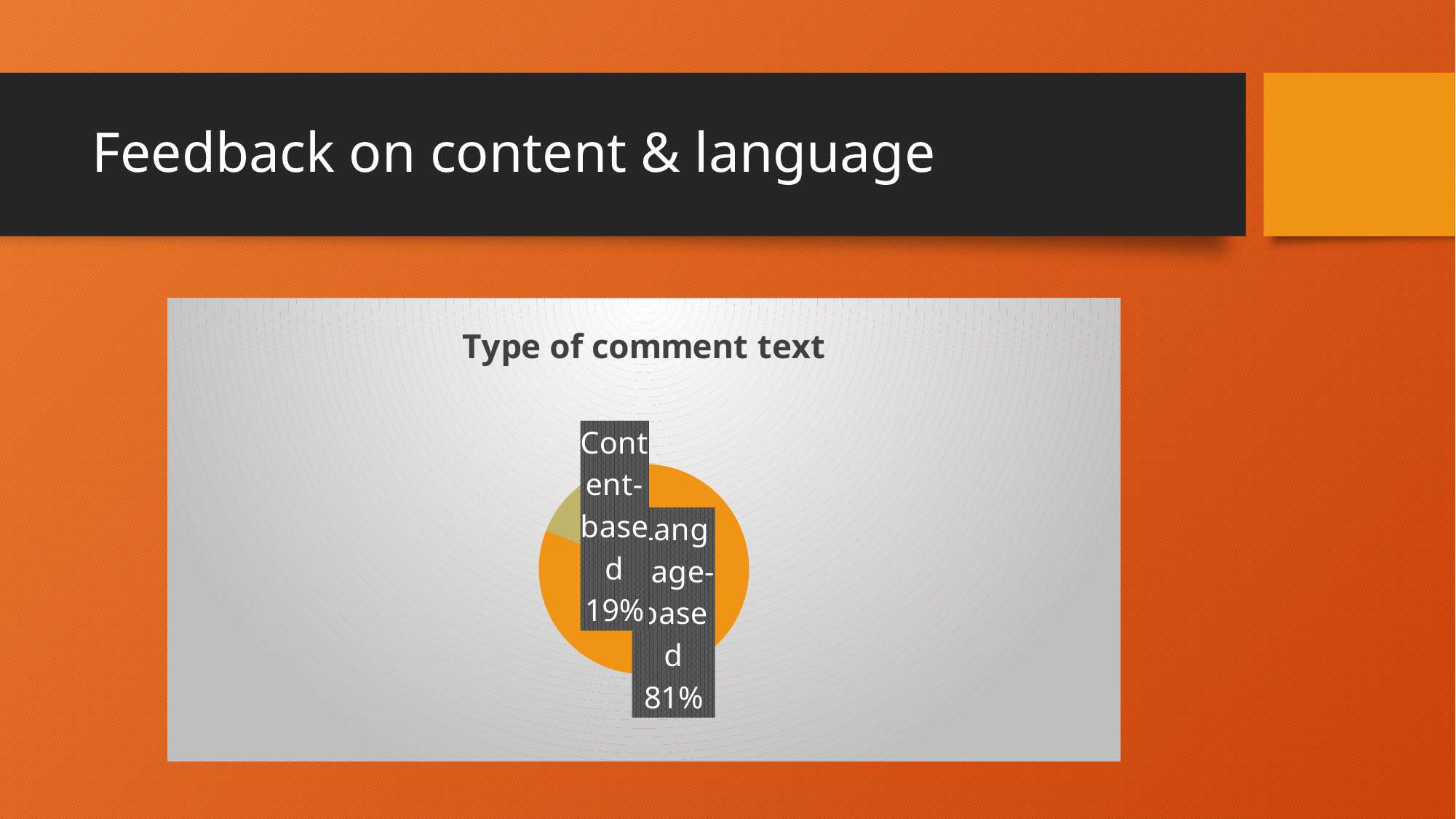
Which type of comment text has the largest share? Language-based What share of comment text is Content-based? 19% What is the combined share of the Content-based and Language-based slices? 100% What share of comment text is Language-based? 81% Which type of comment text has the smallest share? Content-based Is the Language-based share greater or less than 50%? greater What is the title of the chart? Type of comment text Which is larger, the Content-based share or the Language-based share? Language-based Is the Content-based share greater or less than 25%? less How many slices does the pie chart have? 2 What is the difference in percentage points between the Language-based and Content-based shares? 62 What type of chart is shown on the slide? pie chart